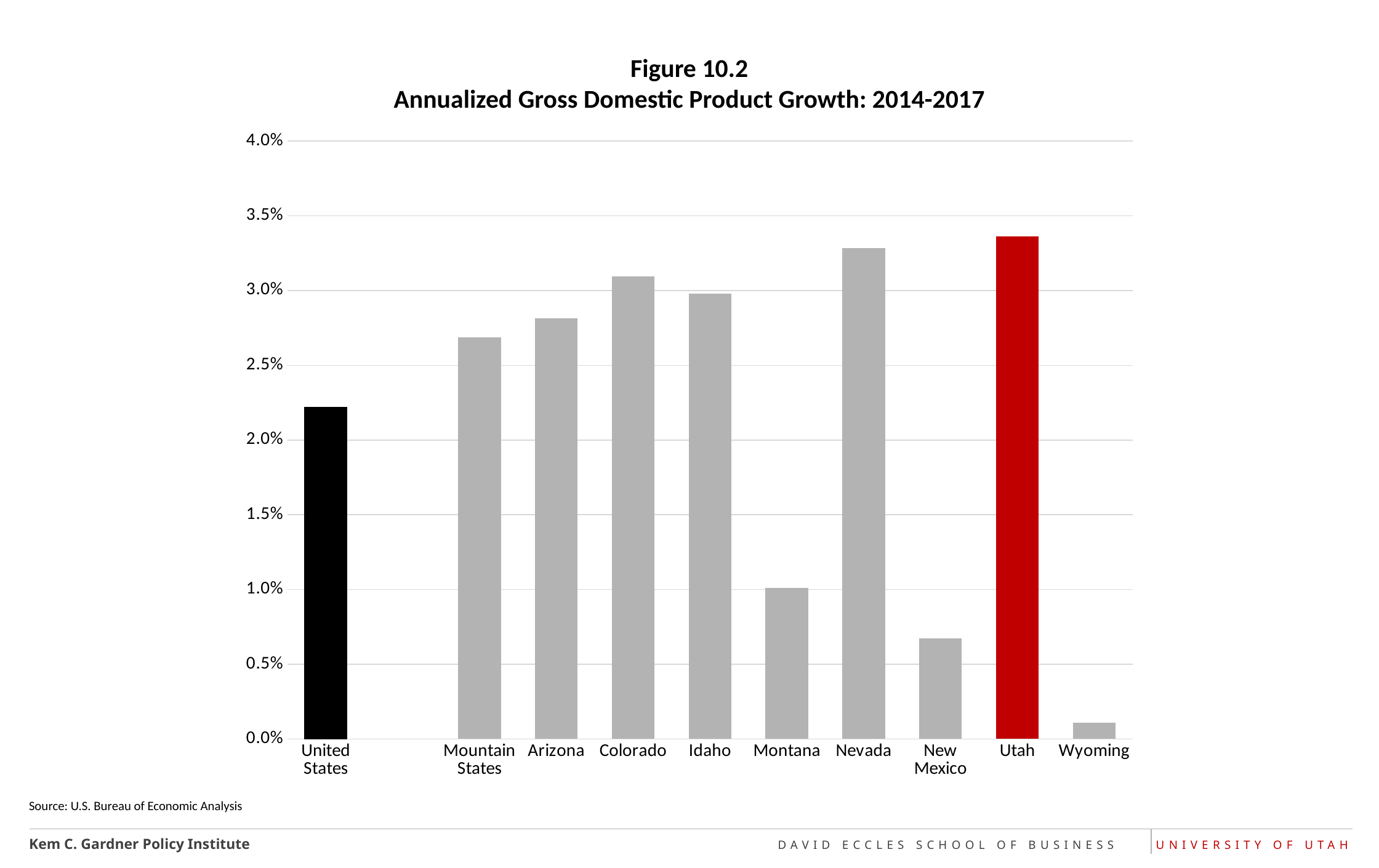
Which has the larger value, Montana or New Mexico? Montana What colour is the bar for Utah? red Is the value for Wyoming greater or less than 0.5%? less Is the value for United States greater or less than 2.0%? greater Is the value for Utah greater or less than 3.5%? less Which has the larger value, Colorado or Idaho? Colorado What kind of chart is shown on the slide? bar chart Which category has the highest annualized GDP growth? Utah Which category has the lowest annualized GDP growth? Wyoming How many bars are plotted in the chart? 10